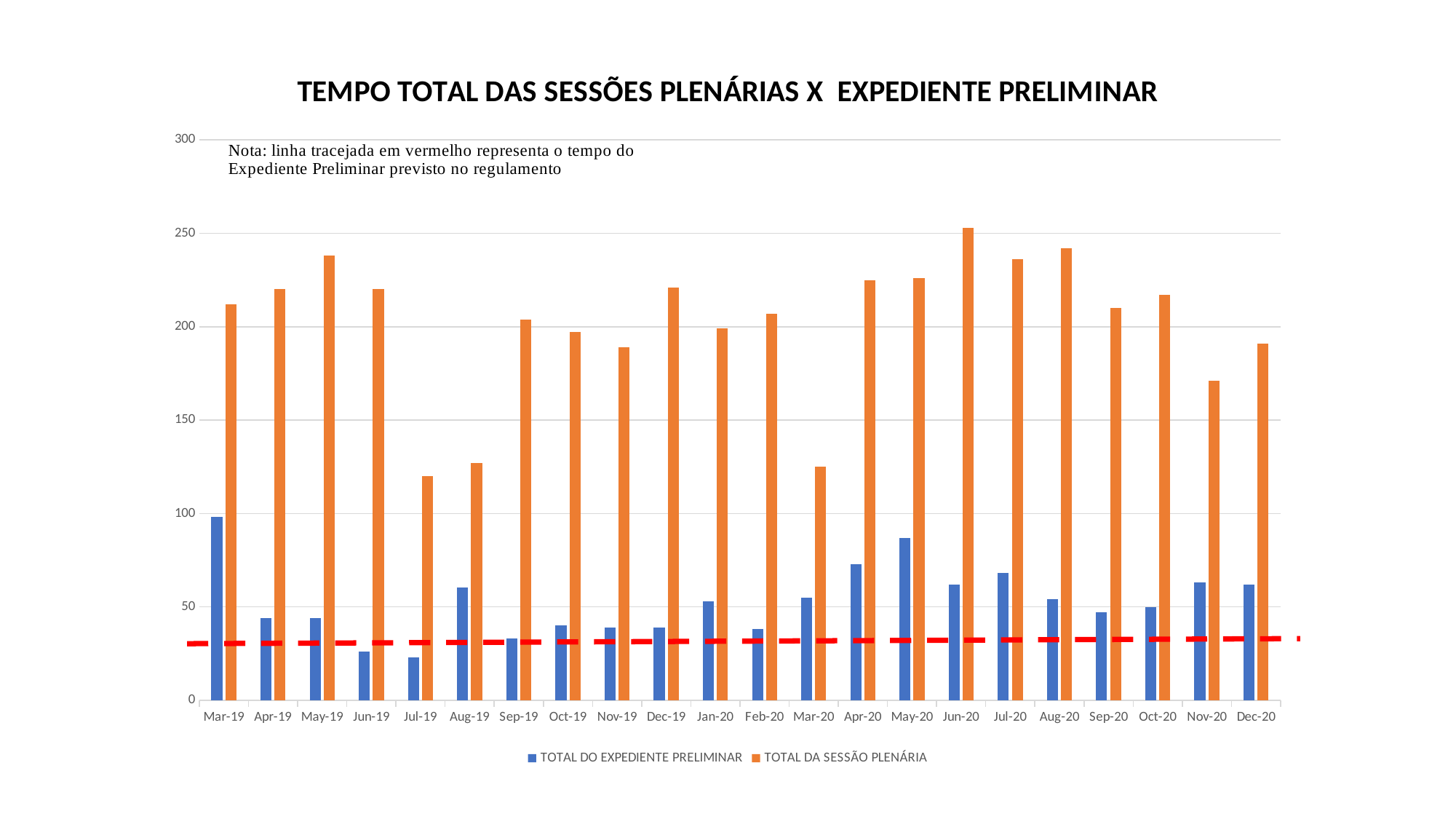
Which month has the lowest value for TOTAL DA SESSÃO PLENÁRIA? Jul-19 What kind of chart is shown on the slide? bar chart What does the red dashed line represent, according to the note on the chart? O tempo do Expediente Preliminar previsto no regulamento Which month has the highest value for TOTAL DA SESSÃO PLENÁRIA? Jun-20 Is the value for TOTAL DA SESSÃO PLENÁRIA in Jul-19 greater or less than 150? less Which month has the lowest value for TOTAL DO EXPEDIENTE PRELIMINAR? Jul-19 Which is larger, TOTAL DA SESSÃO PLENÁRIA in Apr-19 or in Nov-20? Apr-19 How many months (categories) are shown on the x axis? 22 Is the value for TOTAL DA SESSÃO PLENÁRIA in May-19 greater or less than 200? greater Which month has the highest value for TOTAL DO EXPEDIENTE PRELIMINAR? Mar-19 Is the value for TOTAL DO EXPEDIENTE PRELIMINAR in May-20 greater or less than 50? greater How many series does the legend list? 2